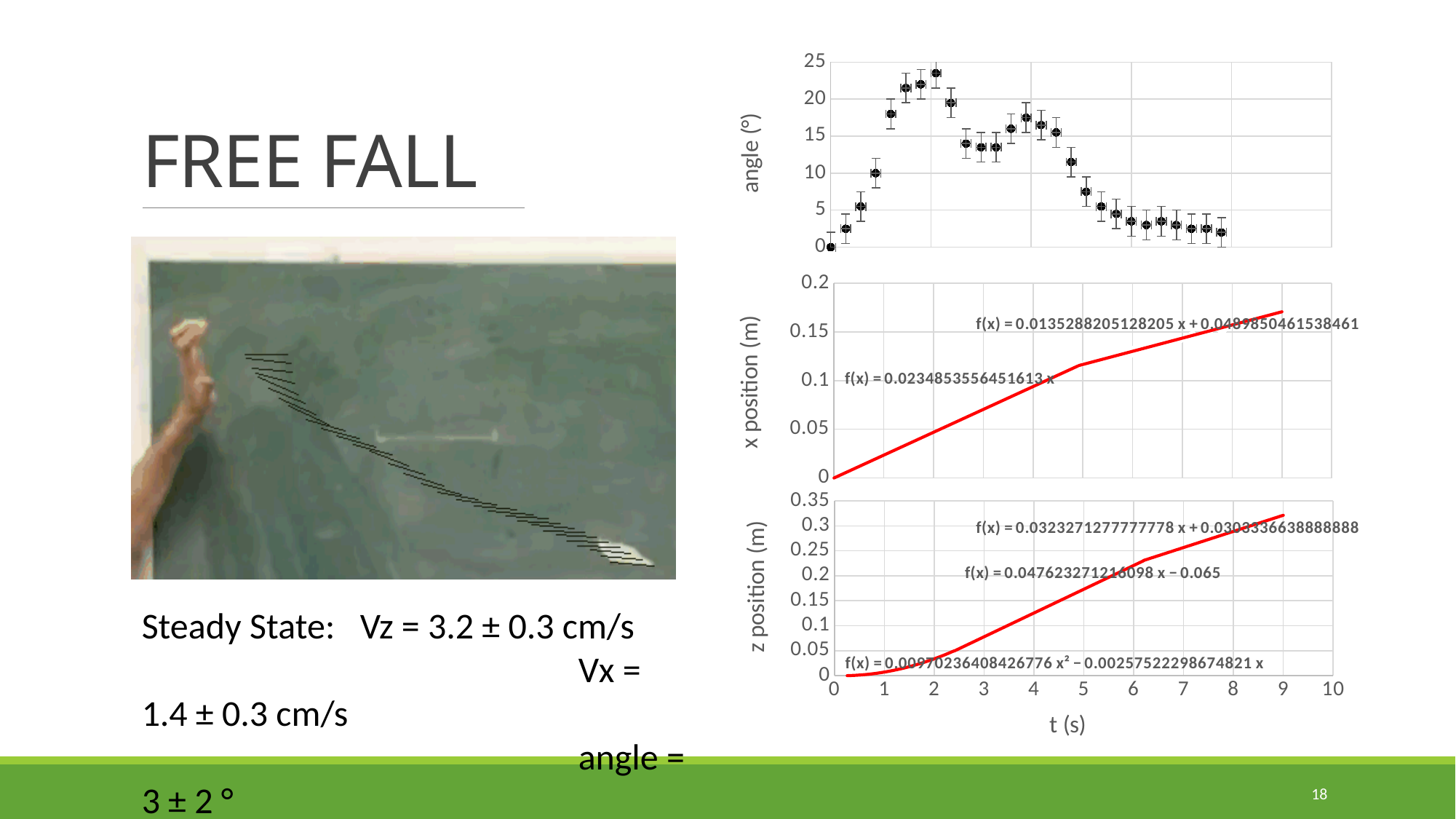
In the middle chart (x position), is the value at t = 9 s greater or less than 0.15? greater In the middle chart (x position), is the value at t = 5 s greater or less than 0.1? greater In the bottom chart (z position), is the value at t = 9 s greater or less than 0.3? greater What is the label on the shared horizontal axis of the charts? t (s) In the middle chart (x position), do the values rise or fall as t increases? rise In the bottom chart (z position), do the values rise or fall as t increases? rise In the top chart (angle), which is larger: the angle at t = 2 s or the angle at t = 8 s? t = 2 s What kind of chart is the middle chart on the right (x position vs t)? line chart What kind of chart is the top chart on the right (angle vs t)? scatter chart What colour is the plotted line in the bottom chart (z position)? red